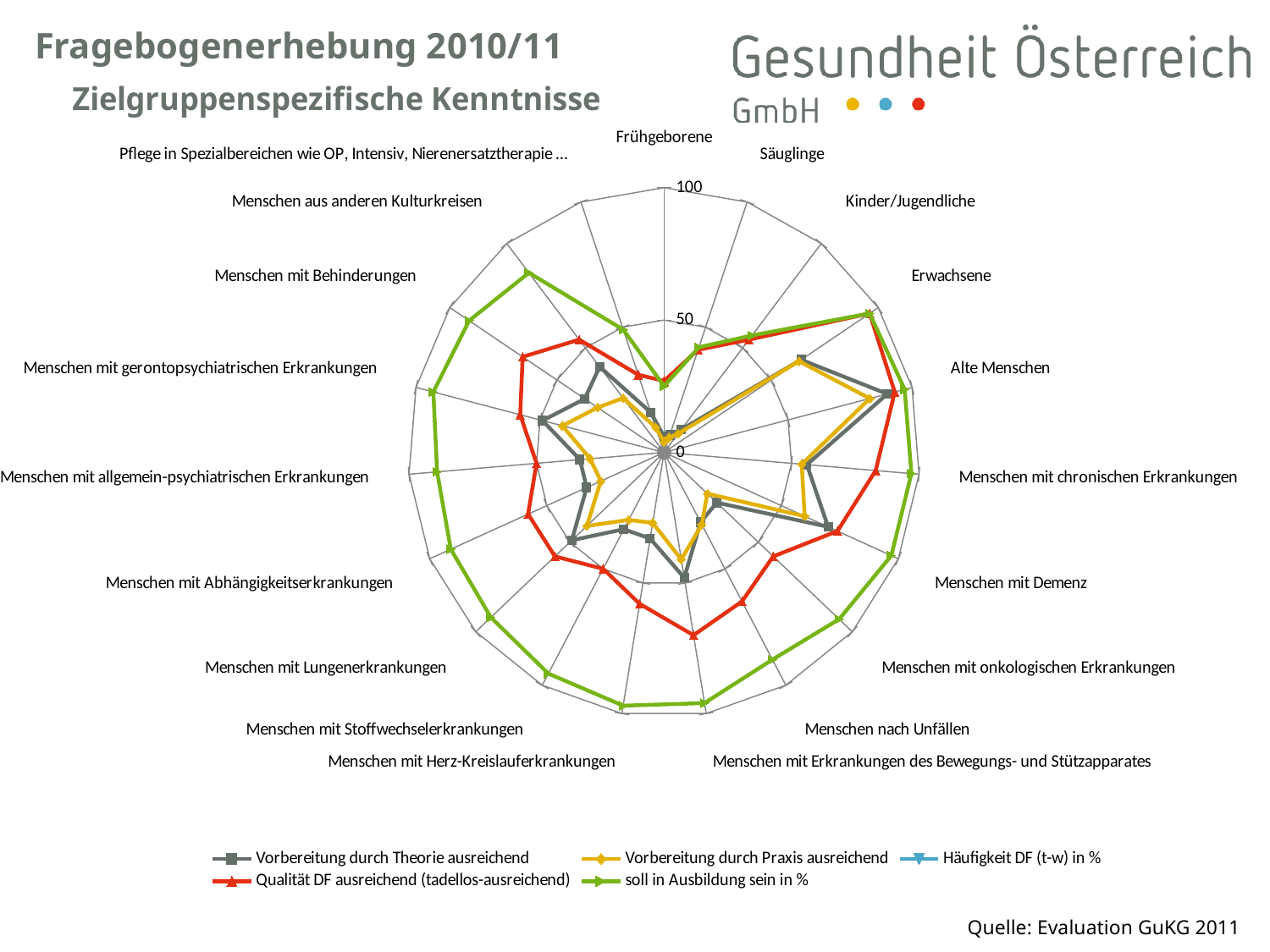
Is the value of 'soll in Ausbildung sein in %' for Alte Menschen greater or less than 50? greater For which category is the 'soll in Ausbildung sein in %' series lowest? Frühgeborene For the 'soll in Ausbildung sein in %' series, which category has the larger value: Alte Menschen or Frühgeborene? Alte Menschen Is the value of 'soll in Ausbildung sein in %' for Frühgeborene greater or less than 50? less For Menschen mit Behinderungen, which series has the larger value: 'soll in Ausbildung sein in %' or 'Vorbereitung durch Theorie ausreichend'? soll in Ausbildung sein in % What kind of chart is shown on the slide? radar chart Is the value of 'Vorbereitung durch Praxis ausreichend' for Alte Menschen greater or less than 50? greater How many categories (axes) does the radar chart have? 19 How many series does the legend list? 5 What is the maximum value shown on the chart's axis scale? 100